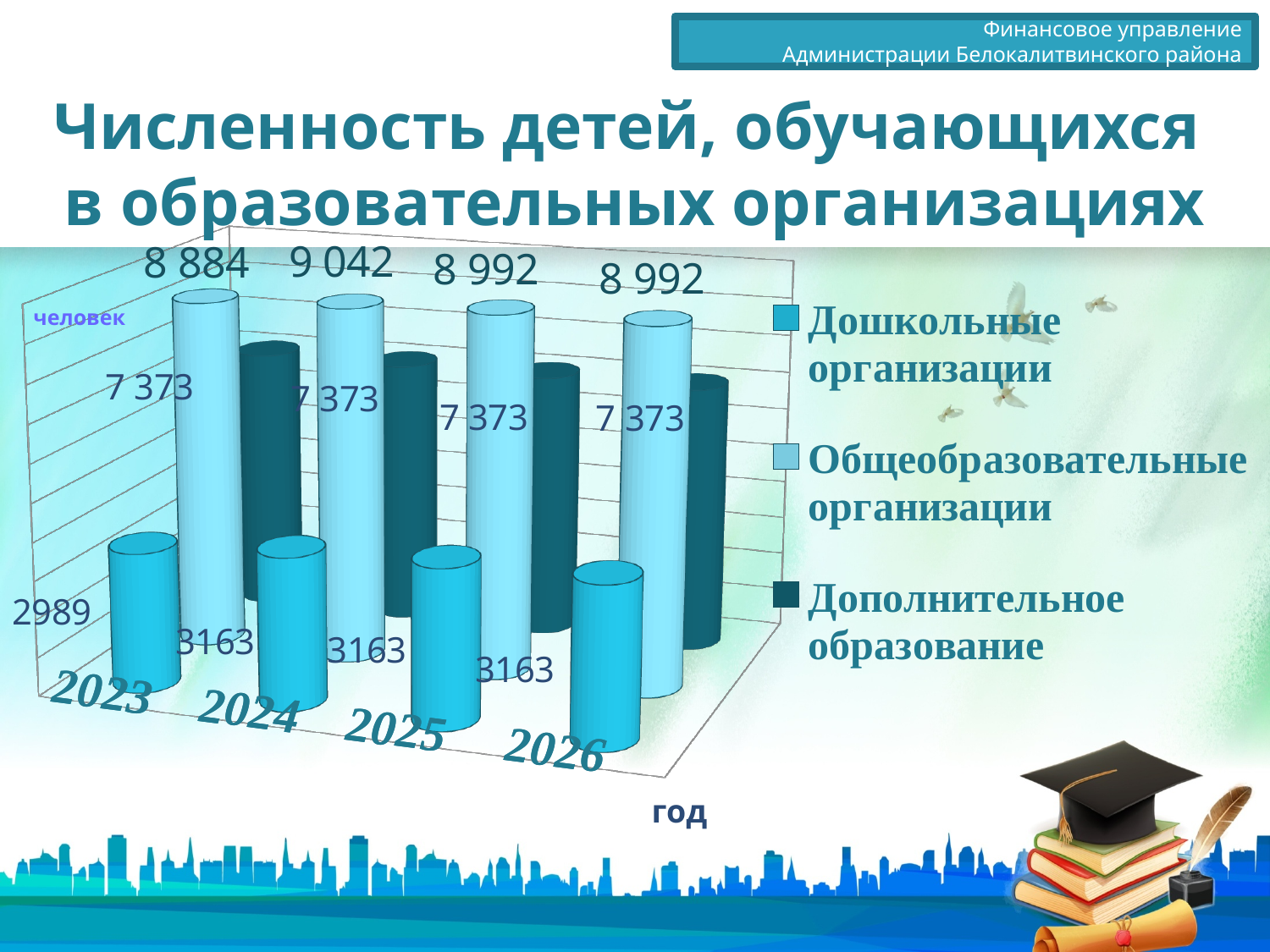
What is the label of the x axis? год How many series does the legend list? 3 Which is larger in 2023: the value for Общеобразовательные организации or for Дополнительное образование? Общеобразовательные организации What is the value for Дополнительное образование in 2025? 7 373 What is the value for Общеобразовательные организации in 2026? 8 992 What kind of chart is shown on the slide? bar chart What is the difference between the Общеобразовательные организации values for 2024 and 2023? 158 What is the value for Общеобразовательные организации in 2024? 9 042 How many years are shown on the x axis? 4 In which year is the value for Общеобразовательные организации highest? 2024 What is the value for Дошкольные организации in 2023? 2989 In which year is the value for Дошкольные организации lowest? 2023